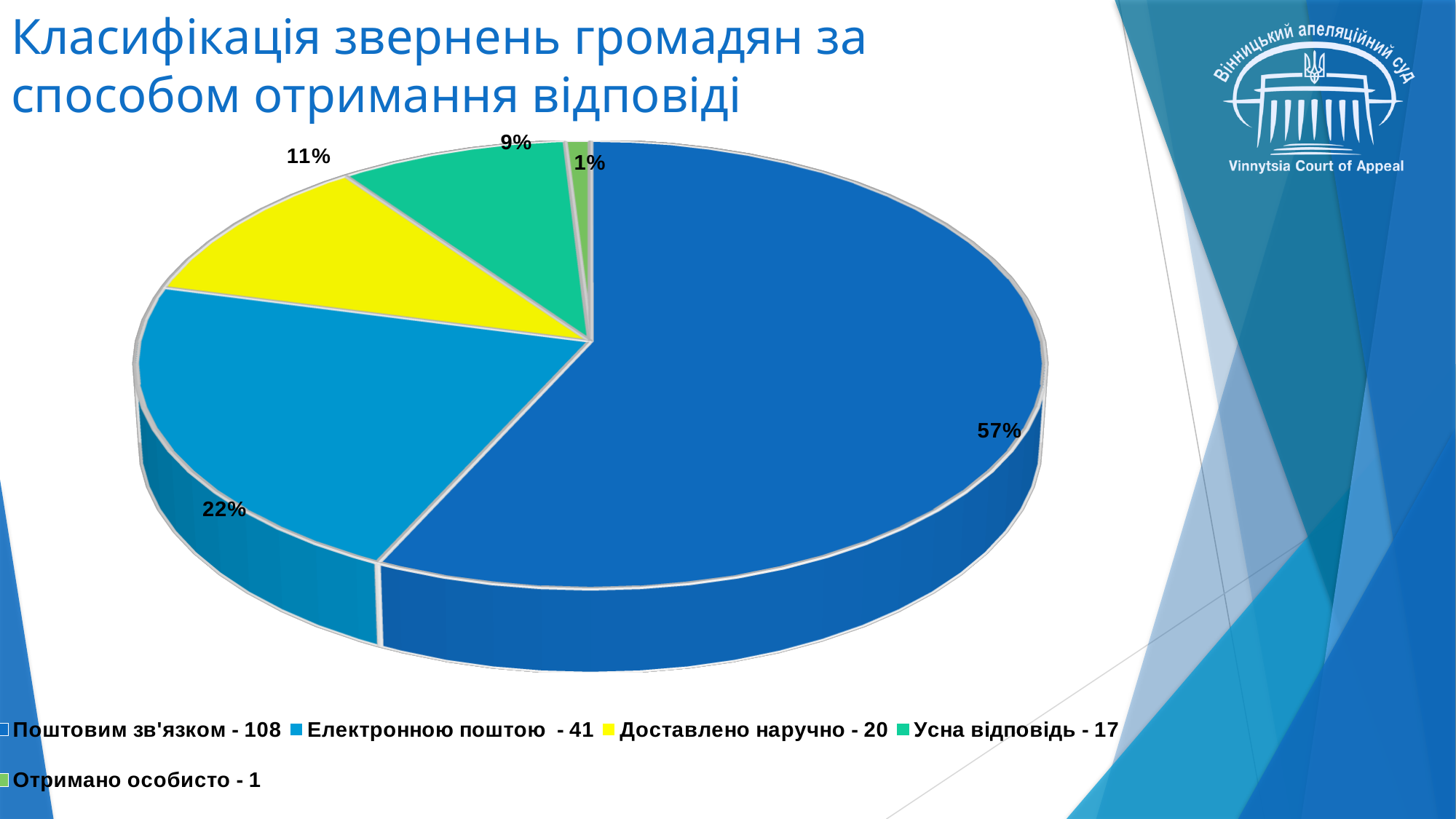
What percentage is shown for "Отримано особисто - 1"? 1% What kind of chart is shown on the slide? pie chart Which category has the smallest slice of the pie? Отримано особисто - 1 Which category has the largest slice of the pie? Поштовим зв'язком - 108 What percentage is shown for "Доставлено наручно - 20"? 11% What is the title of the chart on the slide? Класифікація звернень громадян за способом отримання відповіді How many categories does the pie chart have? 5 What percentage is shown for "Усна відповідь - 17"? 9% What share of the pie does "Поштовим зв'язком - 108" take? 57% What is the difference in percentage points between "Поштовим зв'язком - 108" and "Електронною поштою - 41"? 35 Which slice is larger: "Доставлено наручно - 20" or "Усна відповідь - 17"? Доставлено наручно - 20 What percentage is shown for "Електронною поштою - 41"? 22%